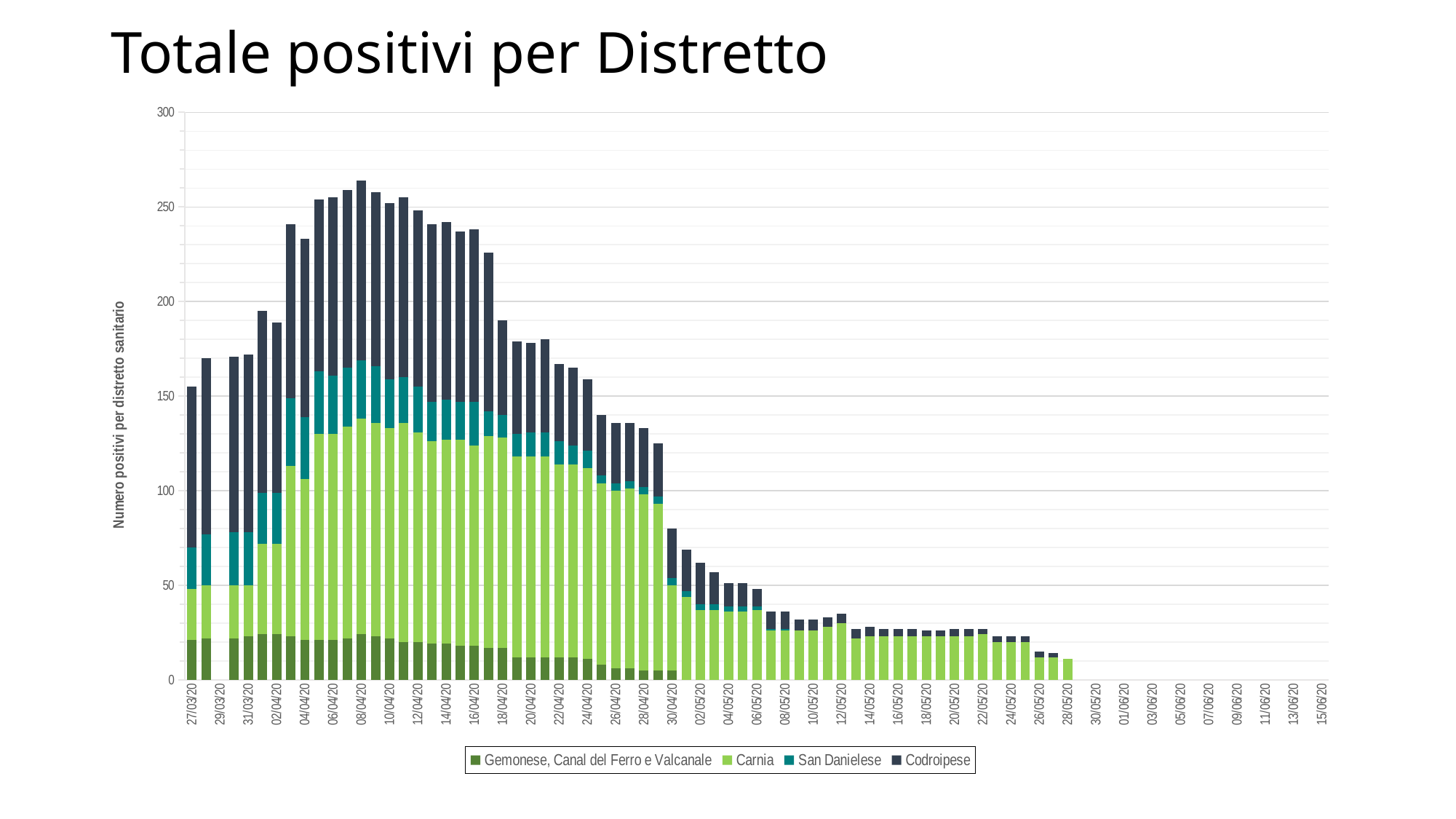
How many series does the legend list? 4 Is the total value for 27/03/20 greater or less than 100? greater What is the title of the chart? Totale positivi per Distretto Is the total value for 08/04/20 greater or less than 250? greater Is the total value for 02/05/20 greater or less than 50? greater What kind of chart is shown on the slide? Stacked bar chart Do the total values rise or fall along the x axis from 08/04/20 to 28/05/20? fall Which date has the larger total, 30/04/20 or 02/05/20? 30/04/20 Which series is shown at the top of each stacked bar? Codroipese Which date has the larger total, 04/04/20 or 06/04/20? 06/04/20